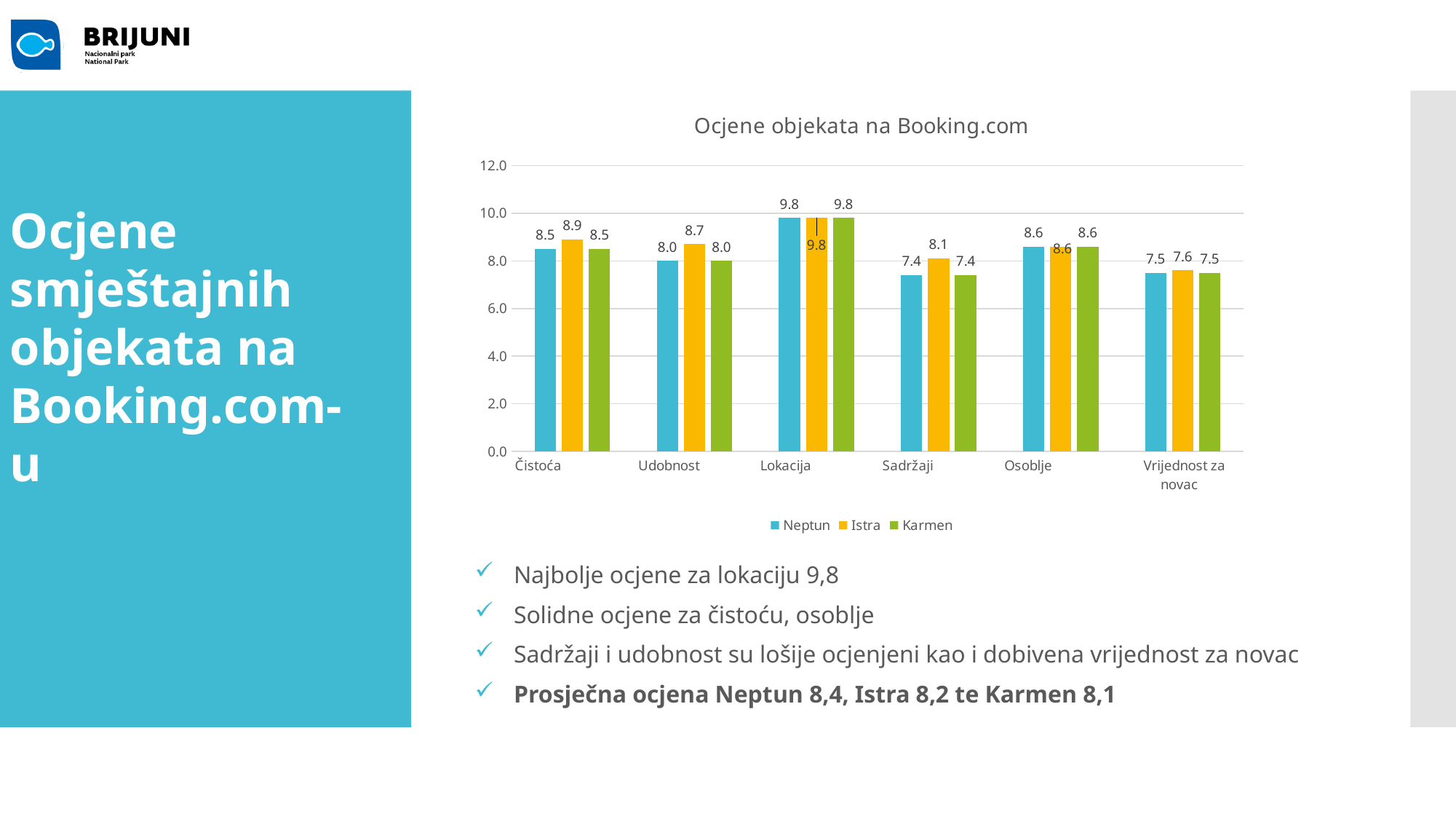
What is the difference between the Istra value for Čistoća and the Istra value for Sadržaji? 0.8 What is the Istra value for Udobnost? 8.7 Which category has the lowest Istra value? Vrijednost za novac How many series does the legend list? 3 What is the Neptun value for Sadržaji? 7.4 Which category has the highest Neptun value? Lokacija Is the Neptun value for Lokacija greater or less than 8.0? greater Which is larger, the Istra value for Udobnost or the Istra value for Osoblje? Udobnost What is the Karmen value for Vrijednost za novac? 7.5 How many categories are shown on the x axis? 6 What kind of chart is shown on the slide? bar chart What is the title of the chart? Ocjene objekata na Booking.com